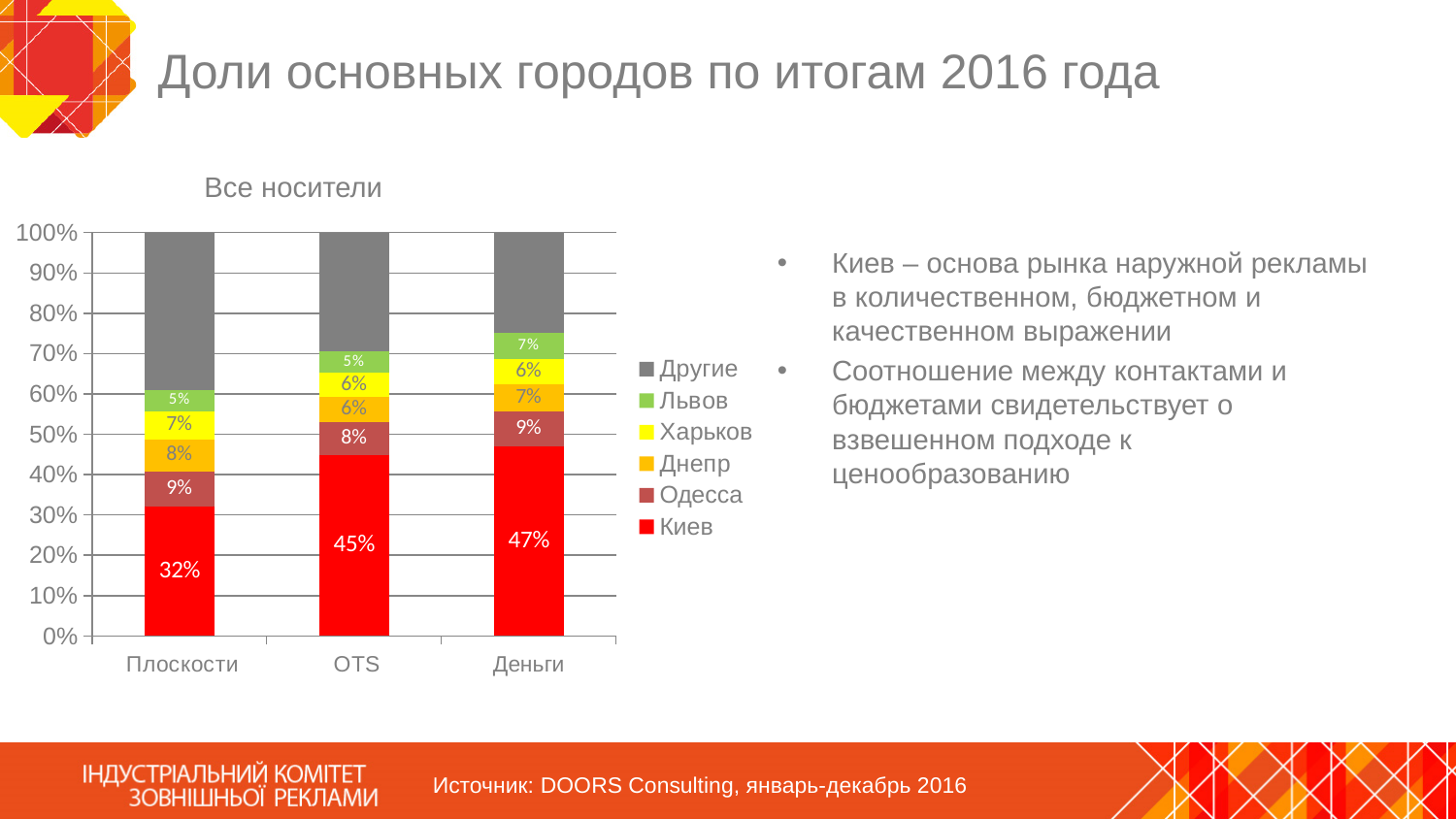
What is the value for Киев in the Деньги bar? 47% What is the value for Киев in the Плоскости bar? 32% In which category does Киев have the highest share? Деньги What is the value for Днепр in the Плоскости bar? 8% In which category does Киев have the lowest share? Плоскости What kind of chart is shown on the slide? Stacked bar chart How many series does the legend list? 6 Which is larger: the Киев share in OTS or in Плоскости? OTS What is the value for Одесса in the OTS bar? 8% What is the difference between the Киев share in Деньги and in Плоскости? 15% How many categories are shown on the x axis? 3 What is the value for Львов in the Деньги bar? 7%